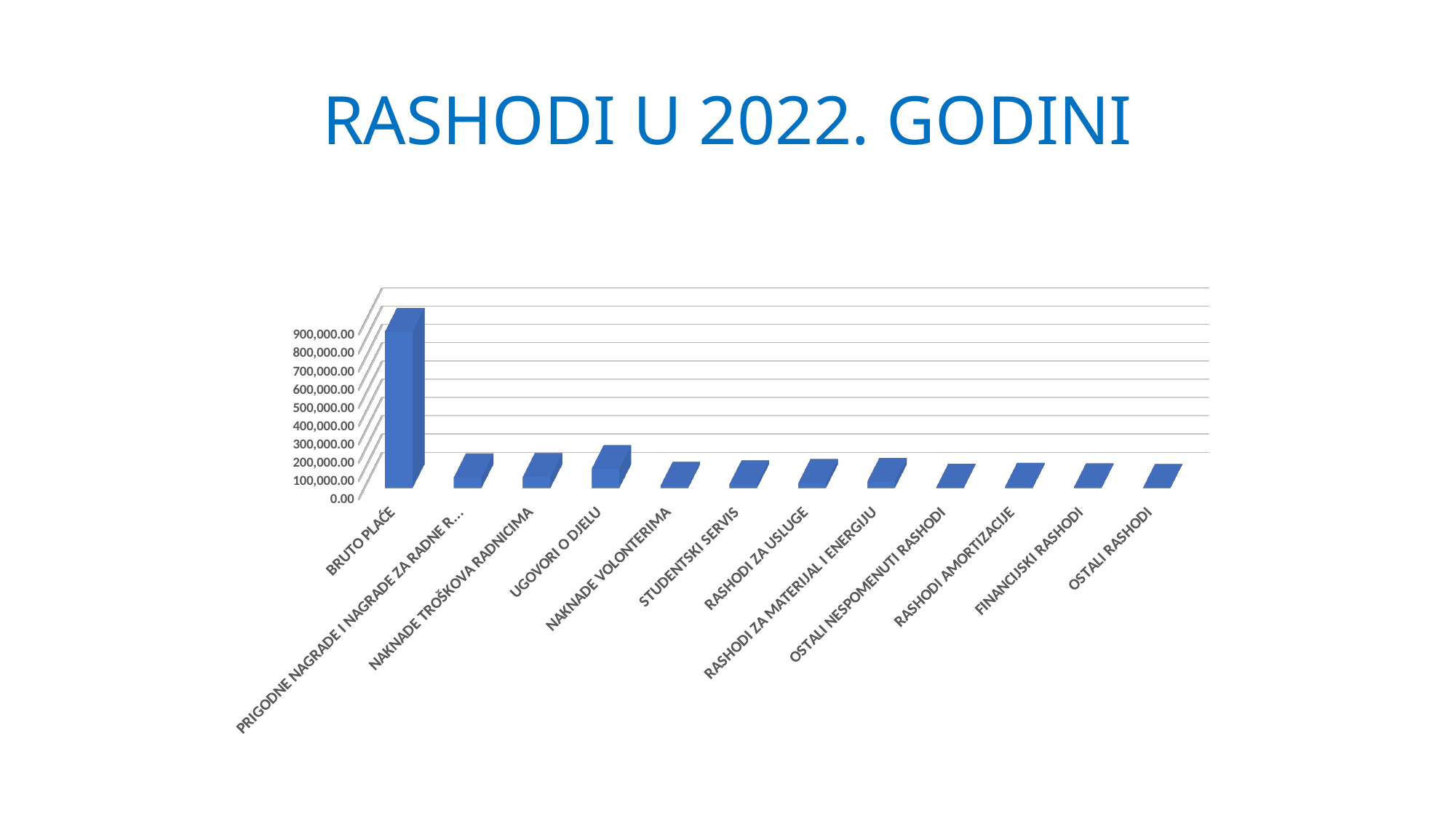
Is the value for OSTALI RASHODI greater or less than 200,000.00? less What colour are the bars in the chart? blue Which is larger, the value for BRUTO PLAĆE or the value for UGOVORI O DJELU? BRUTO PLAĆE Is the value for STUDENTSKI SERVIS greater or less than 300,000.00? less What is the title of the slide? RASHODI U 2022. GODINI Which is larger, the value for UGOVORI O DJELU or the value for NAKNADE VOLONTERIMA? UGOVORI O DJELU Which category has the highest value? BRUTO PLAĆE How many categories are plotted on the chart? 12 What kind of chart is shown on the slide? bar chart Is the value for BRUTO PLAĆE greater or less than 800,000.00? greater What is the highest value labelled on the vertical axis? 900,000.00